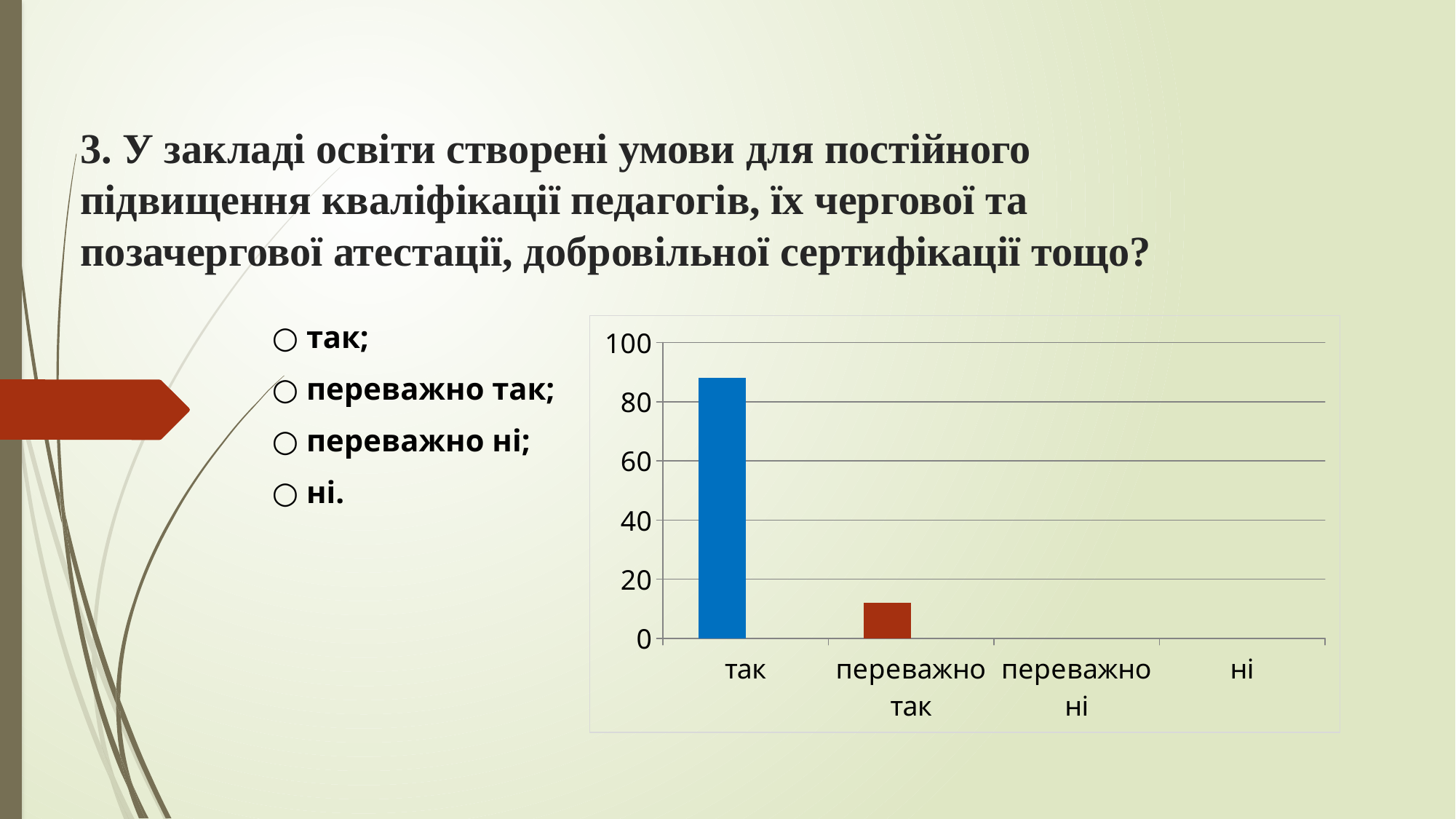
What colour is the bar for "так"? blue Which is larger, the value for "так" or the value for "переважно так"? так What kind of chart is shown on the slide? bar chart What is the highest value shown on the vertical axis of the chart? 100 Is the value for "так" greater or less than 100? less Which is larger, the value for "переважно так" or the value for "ні"? переважно так How many categories are shown on the x axis of the chart? 4 Do the bar values rise or fall moving from left to right along the x axis? fall Which category has the highest bar in the chart? так Is the value for "так" greater or less than 80? greater Is the value for "переважно так" greater or less than 20? less